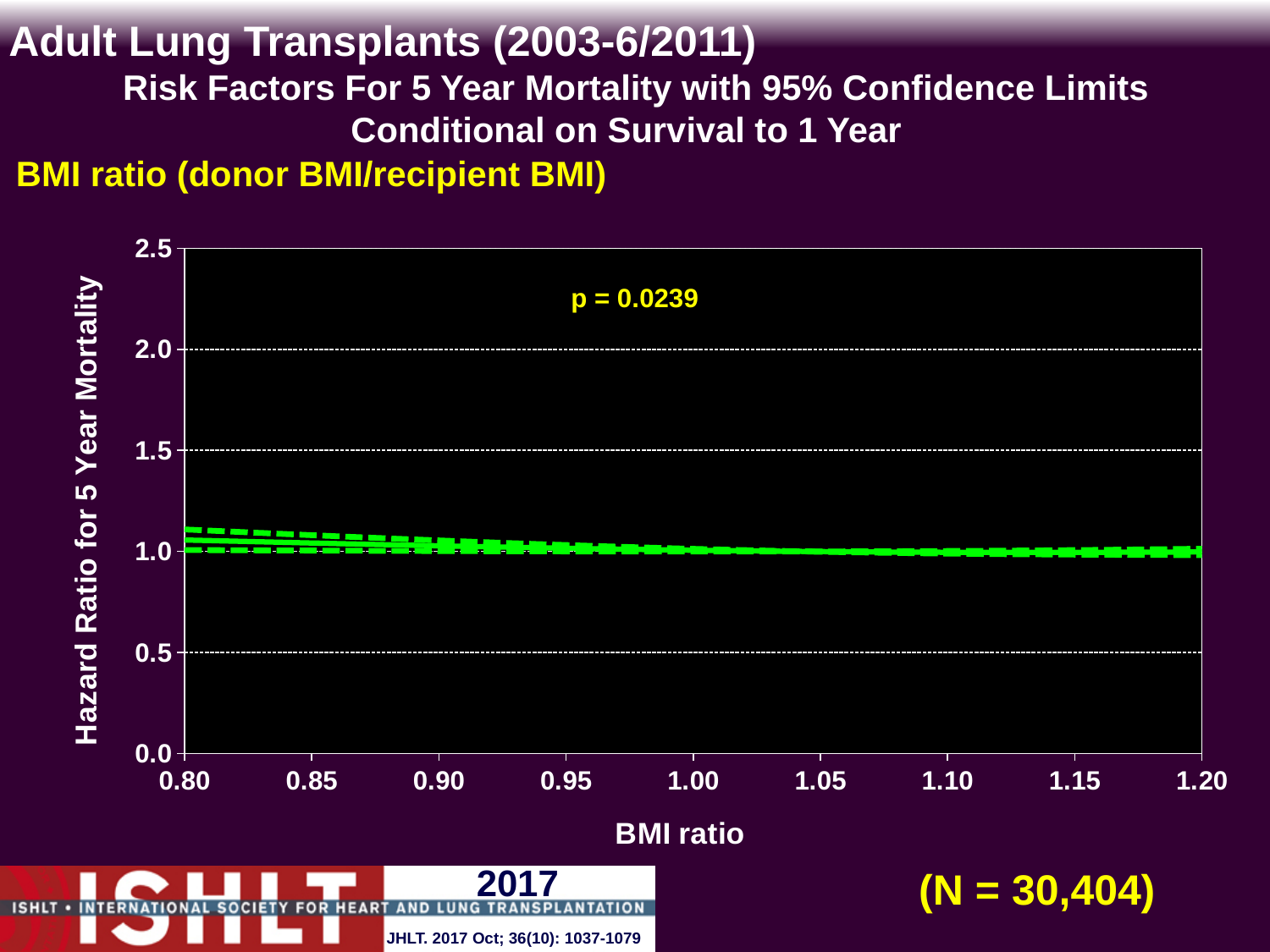
Is the hazard ratio at a BMI ratio of 0.80 greater or less than 1.5? less Does the hazard ratio rise or fall as the BMI ratio increases from 0.80 to 1.20? fall What kind of chart is shown on the slide? line chart What sample size (N) is shown on the slide? N = 30,404 What is the label of the y axis? Hazard Ratio for 5 Year Mortality Is the upper confidence limit at a BMI ratio of 0.80 greater or less than 2.0? less What is the range of BMI ratio values shown on the x axis? 0.80 to 1.20 What p-value is printed on the chart? p = 0.0239 What is the maximum value shown on the y axis? 2.5 What is the label of the x axis? BMI ratio Which has the higher hazard ratio, a BMI ratio of 0.80 or a BMI ratio of 1.20? 0.80 Is the hazard ratio at a BMI ratio of 1.20 greater or less than 0.5? greater